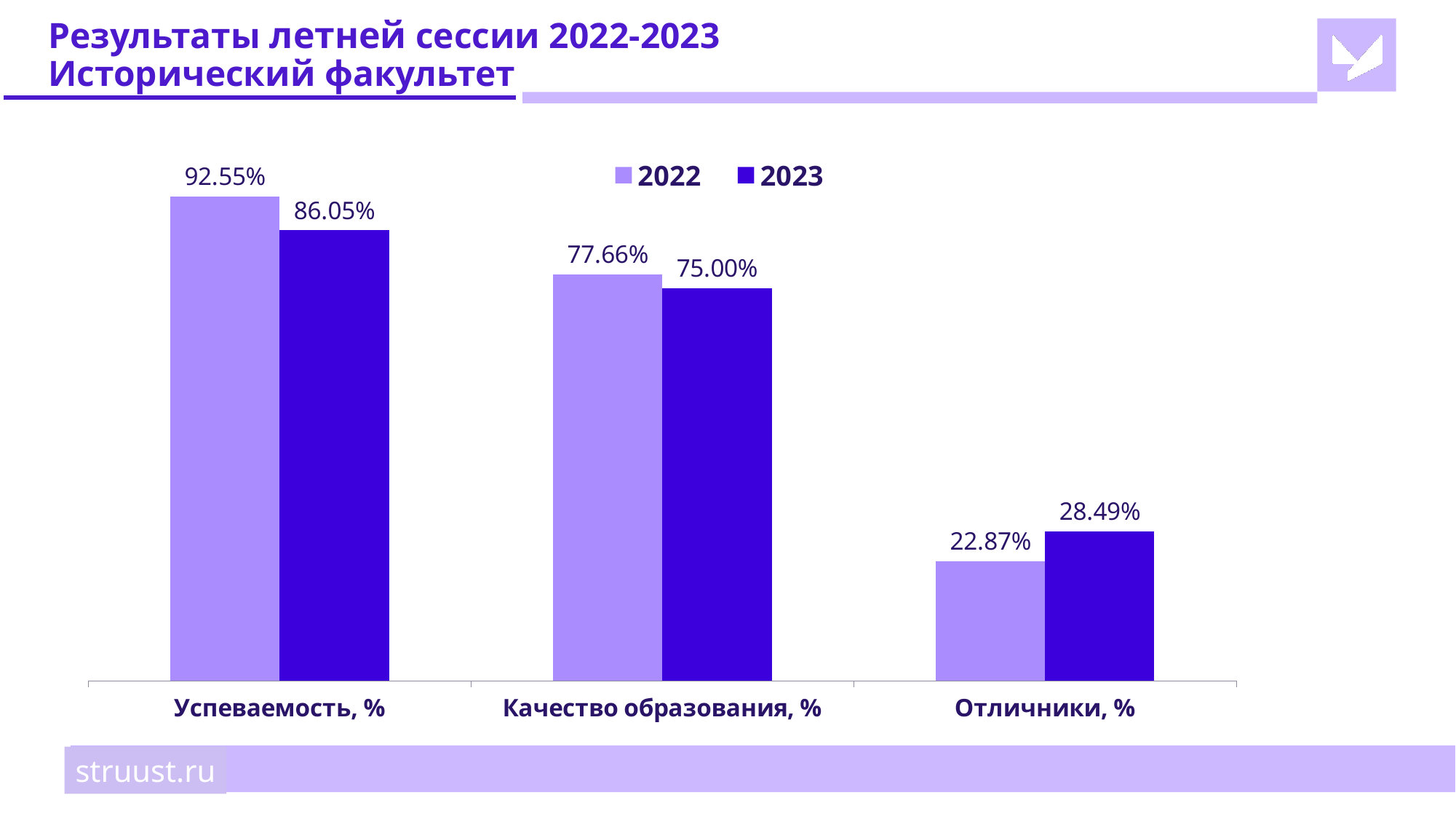
How many categories are shown on the x axis? 3 What is the difference between the 2022 and 2023 values for Успеваемость, %? 6.50% Which category has the lowest value in the 2023 series? Отличники, % For Качество образования, %, which year has the larger value, 2022 or 2023? 2022 What is the value for Отличники, % in 2023? 28.49% How many series does the legend list? 2 What kind of chart is shown on the slide? Bar chart What is the value for Успеваемость, % in 2022? 92.55% Which category has the highest value in the 2022 series? Успеваемость, % For Отличники, %, which year has the larger value, 2022 or 2023? 2023 What is the value for Качество образования, % in 2023? 75.00% What is the difference between the 2023 and 2022 values for Отличники, %? 5.62%